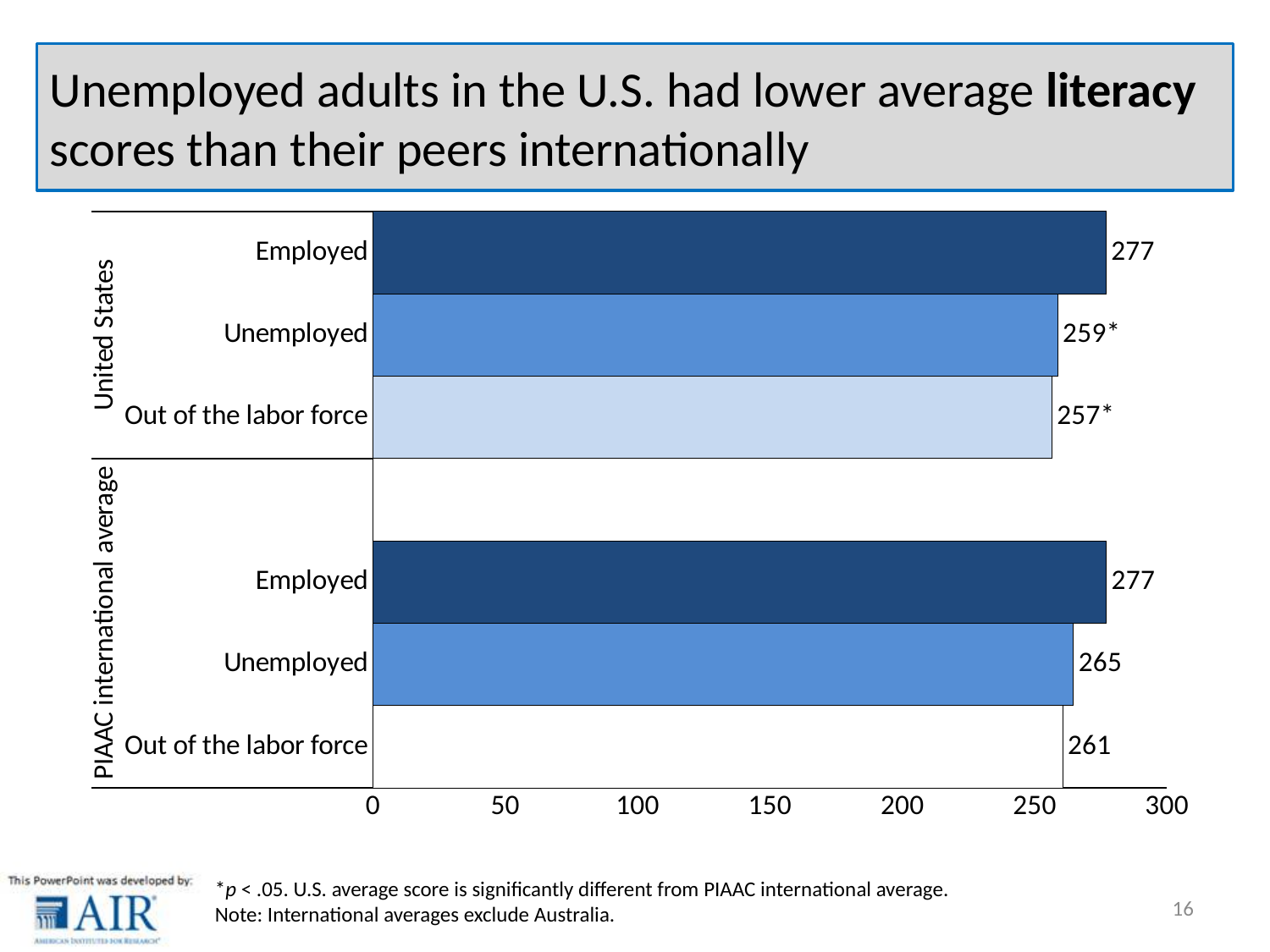
What is the PIAAC international average literacy score for adults out of the labor force? 261 Which is larger: the U.S. score for adults out of the labor force or the PIAAC international average for adults out of the labor force? PIAAC international average How many bars are plotted in the chart? 6 Is the value for unemployed adults in the United States greater or less than 250? greater What is the PIAAC international average literacy score for unemployed adults? 265 How much higher is the PIAAC international average for unemployed adults than the U.S. score for unemployed adults? 6 What is the average literacy score for employed adults in the United States? 277 What value is shown for unemployed adults in the United States? 259* What is the difference between the U.S. employed and U.S. unemployed literacy scores? 18 What type of chart is shown on the slide? Bar chart Which bar in the chart has the lowest value? Out of the labor force (United States) Within the United States group, which category has the highest literacy score? Employed